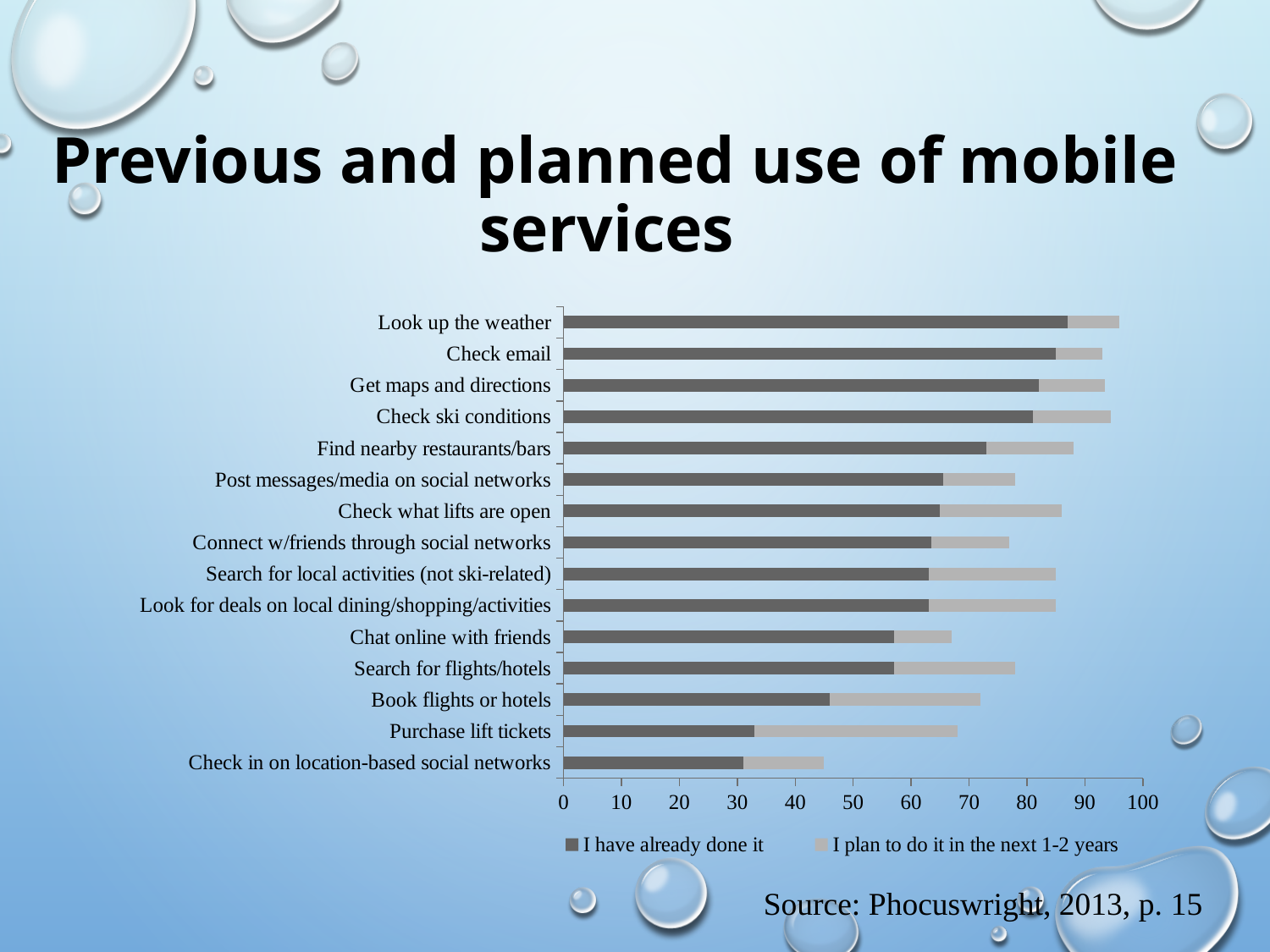
What is the title of the slide containing the chart? Previous and planned use of mobile services Which category has the shortest total stacked bar? Check in on location-based social networks What kind of chart is shown on the slide? Stacked bar chart Is the 'I have already done it' value for 'Find nearby restaurants/bars' greater or less than 70? greater How many mobile service categories are listed on the chart? 15 Is the 'I have already done it' value for 'Book flights or hotels' greater or less than 50? less Which has the larger 'I have already done it' value: 'Book flights or hotels' or 'Purchase lift tickets'? Book flights or hotels Is the 'I have already done it' value for 'Look up the weather' greater or less than 80? greater How many series does the legend list? 2 Which legend entry is shown in the darker grey colour? I have already done it